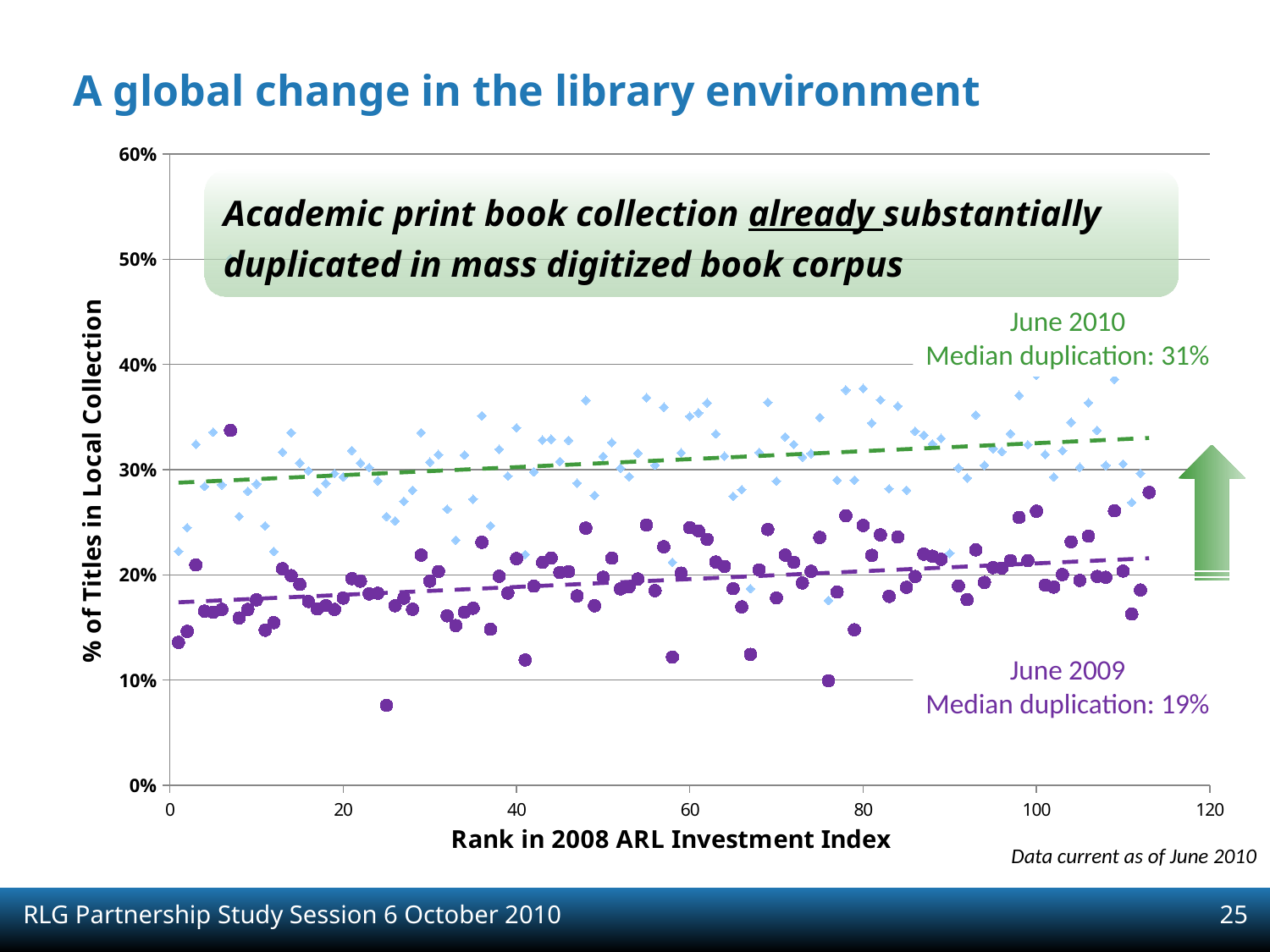
How many data series are plotted on the chart? 2 What is the June 2009 median duplication shown on the chart? 19% What is the label of the x axis? Rank in 2008 ARL Investment Index What is the June 2010 median duplication shown on the chart? 31% Which series has the higher median duplication, June 2009 or June 2010? June 2010 Is the lowest June 2009 value greater or less than 10%? less What kind of chart is shown on the slide? scatter chart By how many percentage points does the June 2010 median duplication exceed the June 2009 median duplication? 12 percentage points What is the label of the y axis? % of Titles in Local Collection Do the dashed trend lines rise or fall as the rank in the 2008 ARL Investment Index increases? rise Is the June 2010 median duplication greater or less than 30%? greater